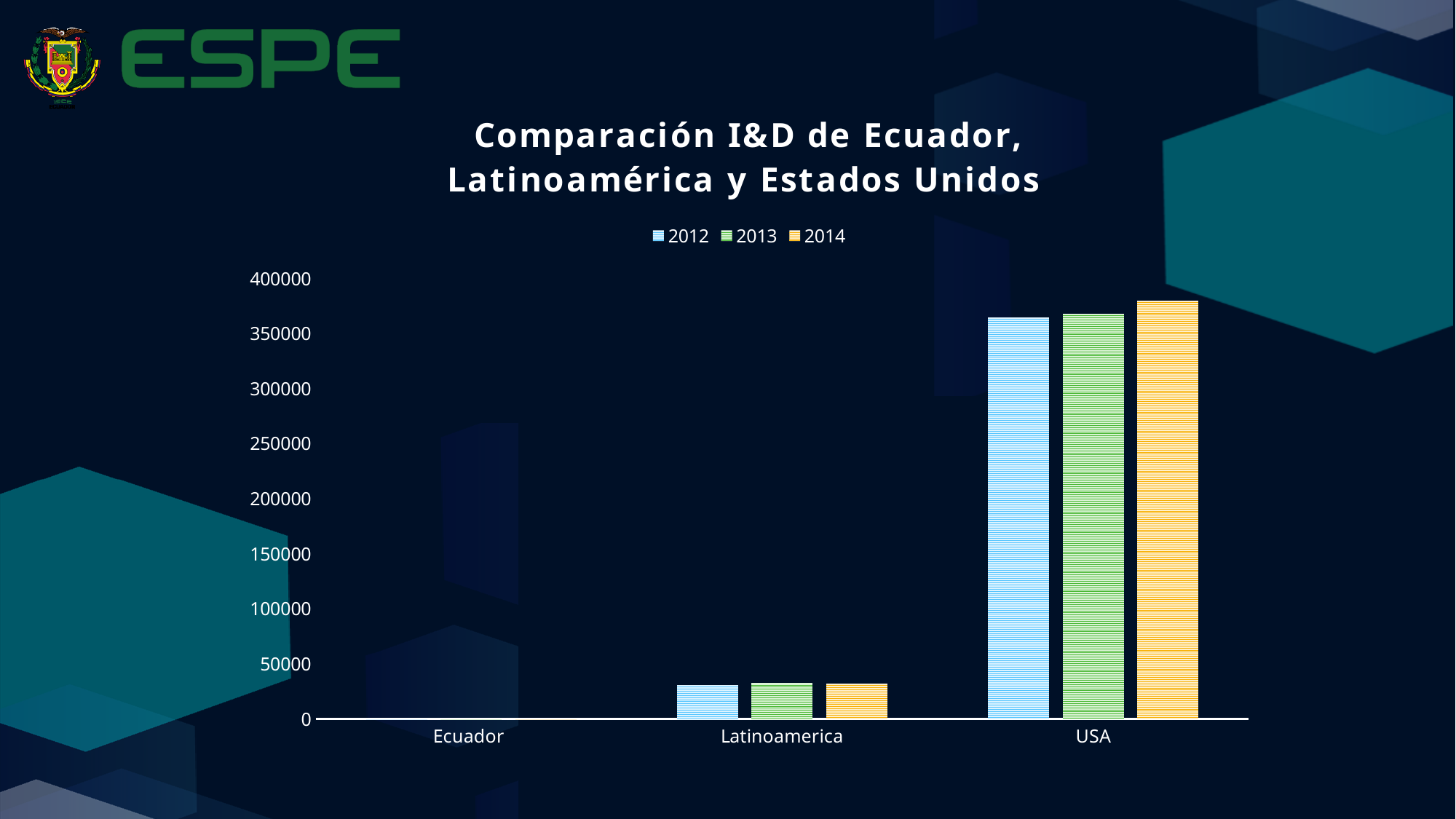
How many categories are shown on the x axis? 3 Which category has the lowest values? Ecuador Which is larger, the 2014 value for USA or the 2014 value for Latinoamerica? USA What kind of chart is shown on the slide? bar chart Is the value for Latinoamerica in 2013 greater or less than 50000? less Is the value for USA in 2014 greater or less than 350000? greater How many series does the legend list? 3 Which category has the highest values? USA Which is larger for USA, the 2012 value or the 2014 value? 2014 What is the title of the chart? Comparación I&D de Ecuador, Latinoamérica y Estados Unidos Is the value for USA in 2012 greater or less than 400000? less Which series is shown in orange in the legend? 2014